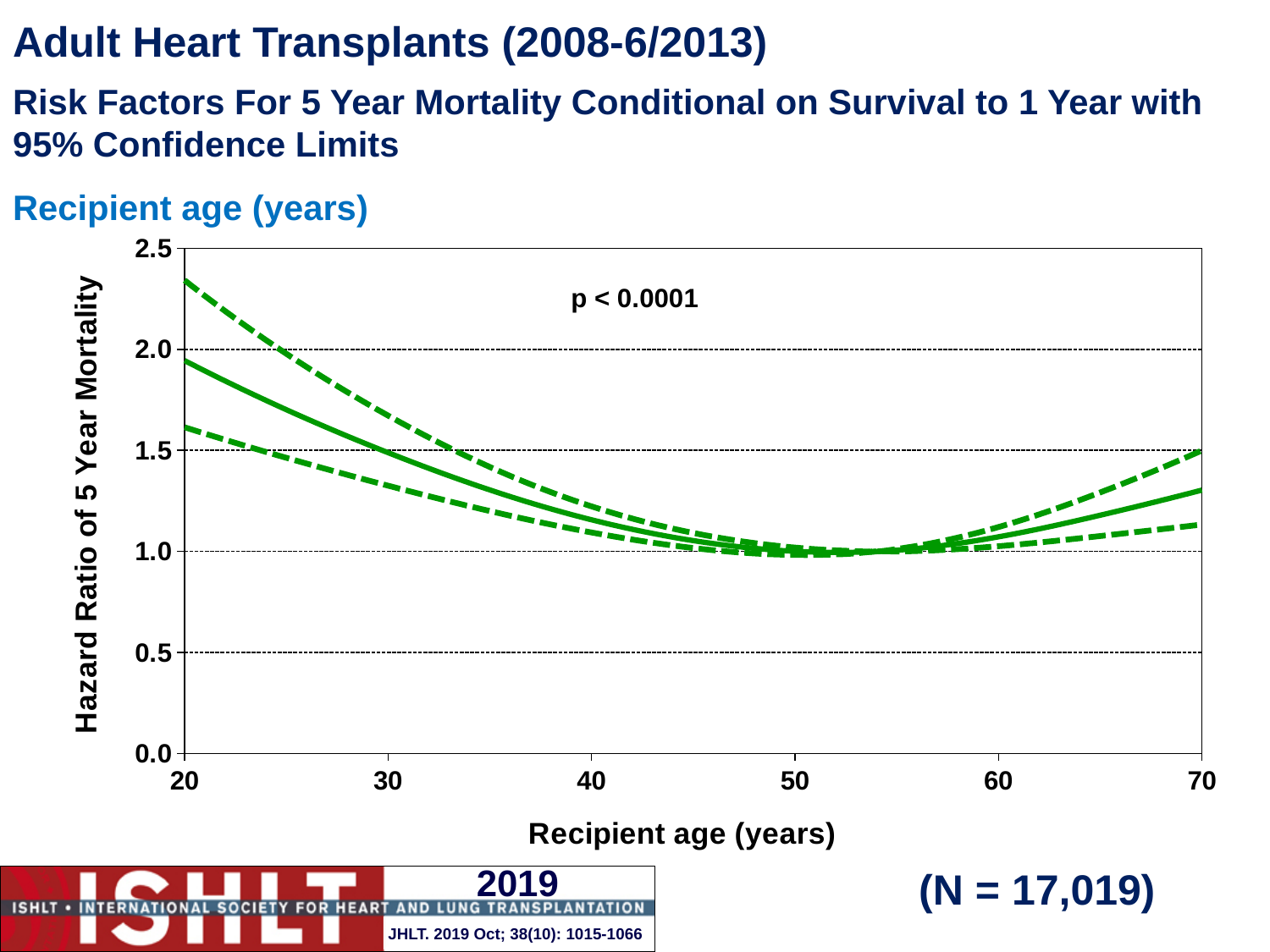
Is the lower confidence limit (lower dashed line) at recipient age 20 greater or less than 2.0? less Is the hazard ratio (solid line) at recipient age 70 greater or less than 1.0? greater What is the label of the x axis? Recipient age (years) What is the label of the y axis? Hazard Ratio of 5 Year Mortality What kind of chart is shown on the slide? line chart Is the hazard ratio (solid line) at recipient age 20 greater or less than 1.5? greater Is the hazard ratio (solid line) larger at recipient age 20 or at recipient age 70? 20 How many lines are plotted on the chart? 3 Does the hazard ratio (solid line) rise or fall as recipient age increases from 20 to 50? fall